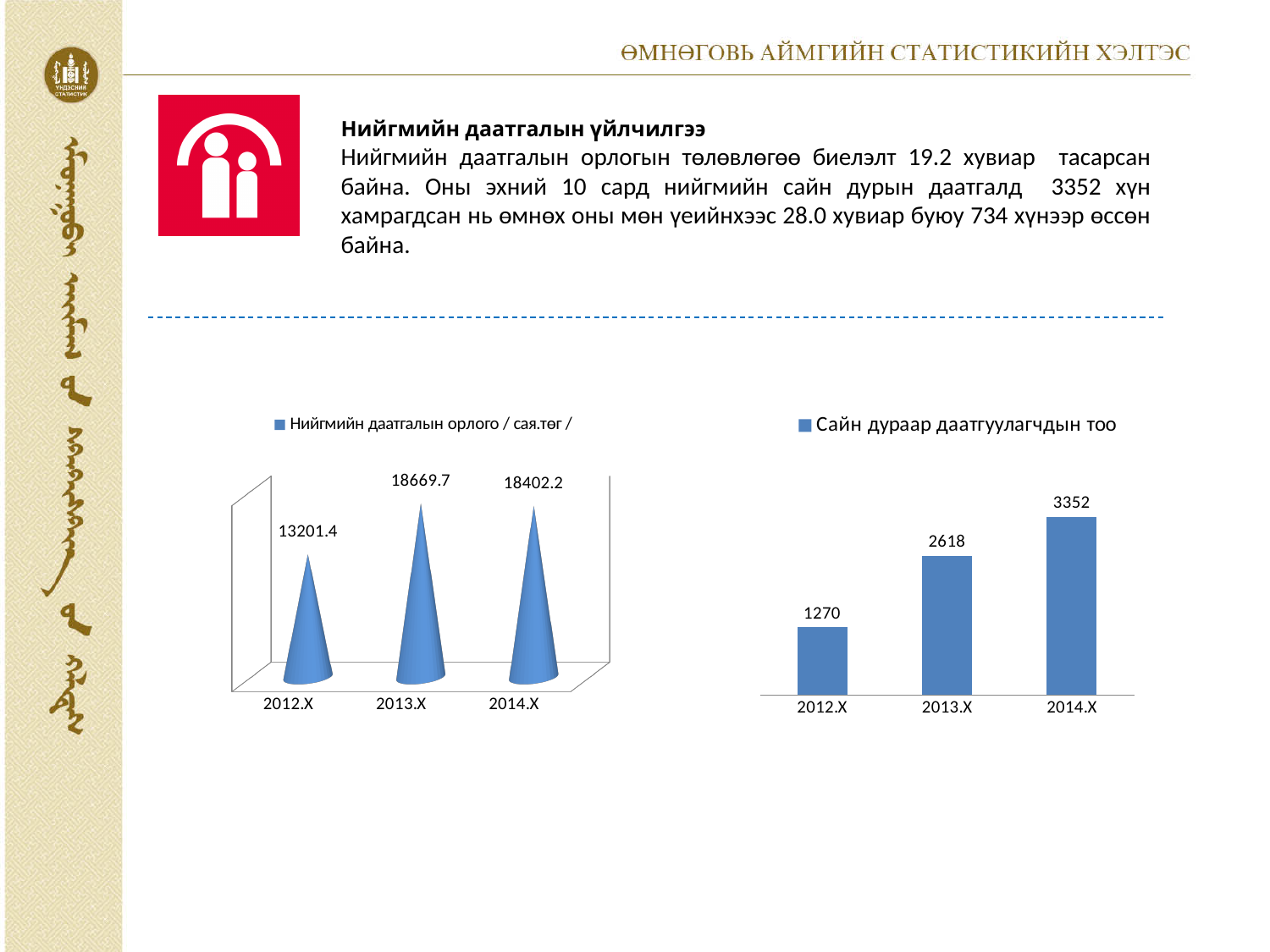
In the right chart (Сайн дураар даатгуулагчдын тоо), what is the difference between the values for 2014.X and 2013.X? 734 In the left chart (Нийгмийн даатгалын орлого / сая.төг /), which year has the highest value? 2013.X In the left chart (Нийгмийн даатгалын орлого / сая.төг /), what is the value for 2013.X? 18669.7 What kind of chart is the right chart (Сайн дураар даатгуулагчдын тоо)? bar chart In the left chart (Нийгмийн даатгалын орлого / сая.төг /), which is larger: the value for 2013.X or 2014.X? 2013.X Do the values in the right chart (Сайн дураар даатгуулагчдын тоо) rise or fall from 2012.X to 2014.X? rise In the right chart (Сайн дураар даатгуулагчдын тоо), what is the value for 2012.X? 1270 In the right chart (Сайн дураар даатгуулагчдын тоо), what is the value for 2014.X? 3352 In the right chart (Сайн дураар даатгуулагчдын тоо), which year has the lowest value? 2012.X In the left chart (Нийгмийн даатгалын орлого / сая.төг /), what is the difference between the values for 2013.X and 2012.X? 5468.3 How many categories are shown on the x axis of the right chart (Сайн дураар даатгуулагчдын тоо)? 3 In the left chart (Нийгмийн даатгалын орлого / сая.төг /), what is the value for 2012.X? 13201.4